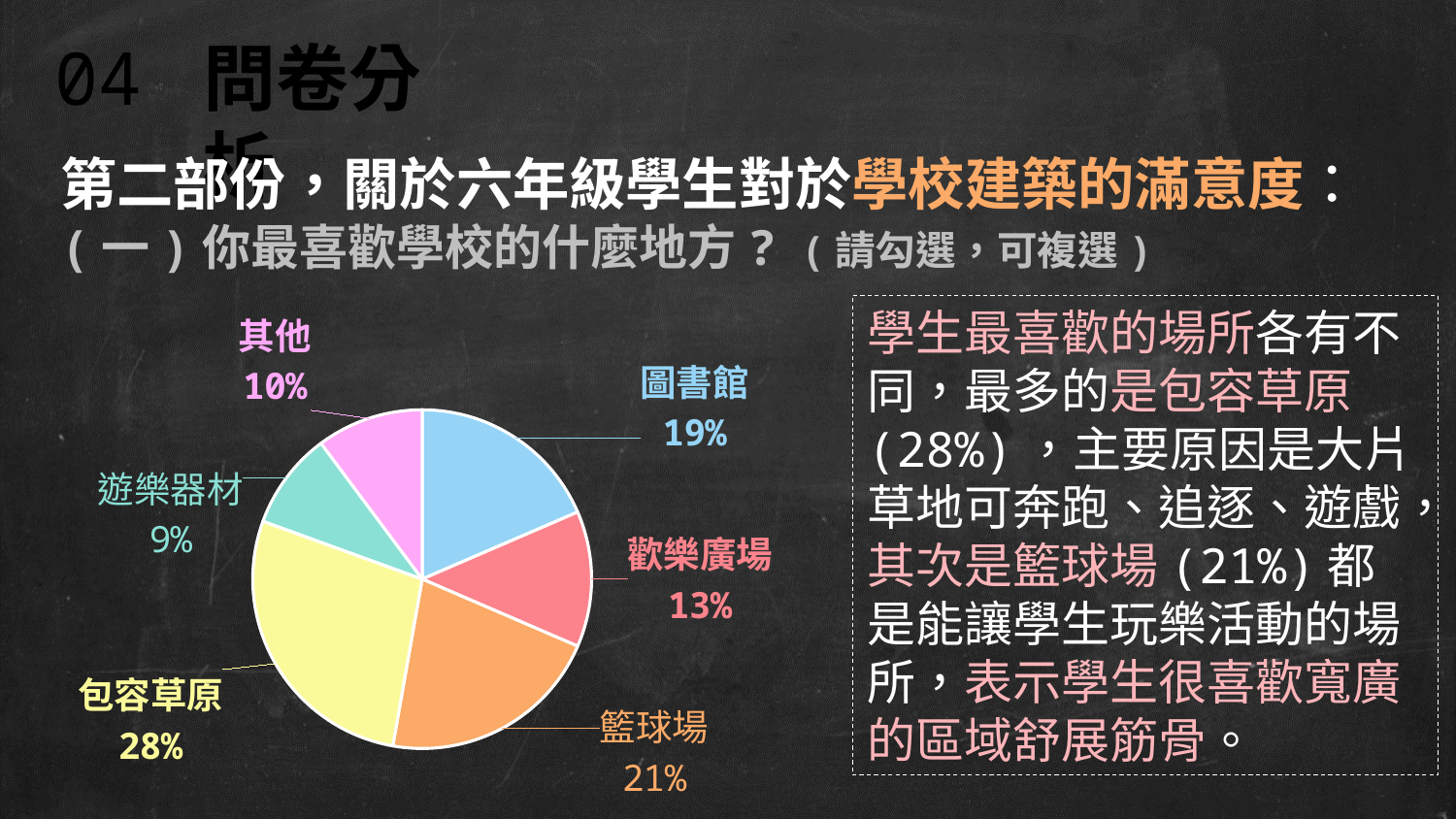
What is the combined share of 其他 and 遊樂器材? 19% What percentage of the pie is 包容草原? 28% What kind of chart is shown on the slide? pie chart Which category has the largest share of the pie? 包容草原 Which is larger, the share for 圖書館 or the share for 歡樂廣場? 圖書館 What percentage of the pie is 圖書館? 19% What percentage of the pie is 歡樂廣場? 13% Which category has the smallest share of the pie? 遊樂器材 How many slices does the pie chart have? 6 What colour is the 籃球場 slice of the pie? orange What is the difference in percentage points between 包容草原 and 籃球場? 7 What percentage of the pie is 遊樂器材? 9%